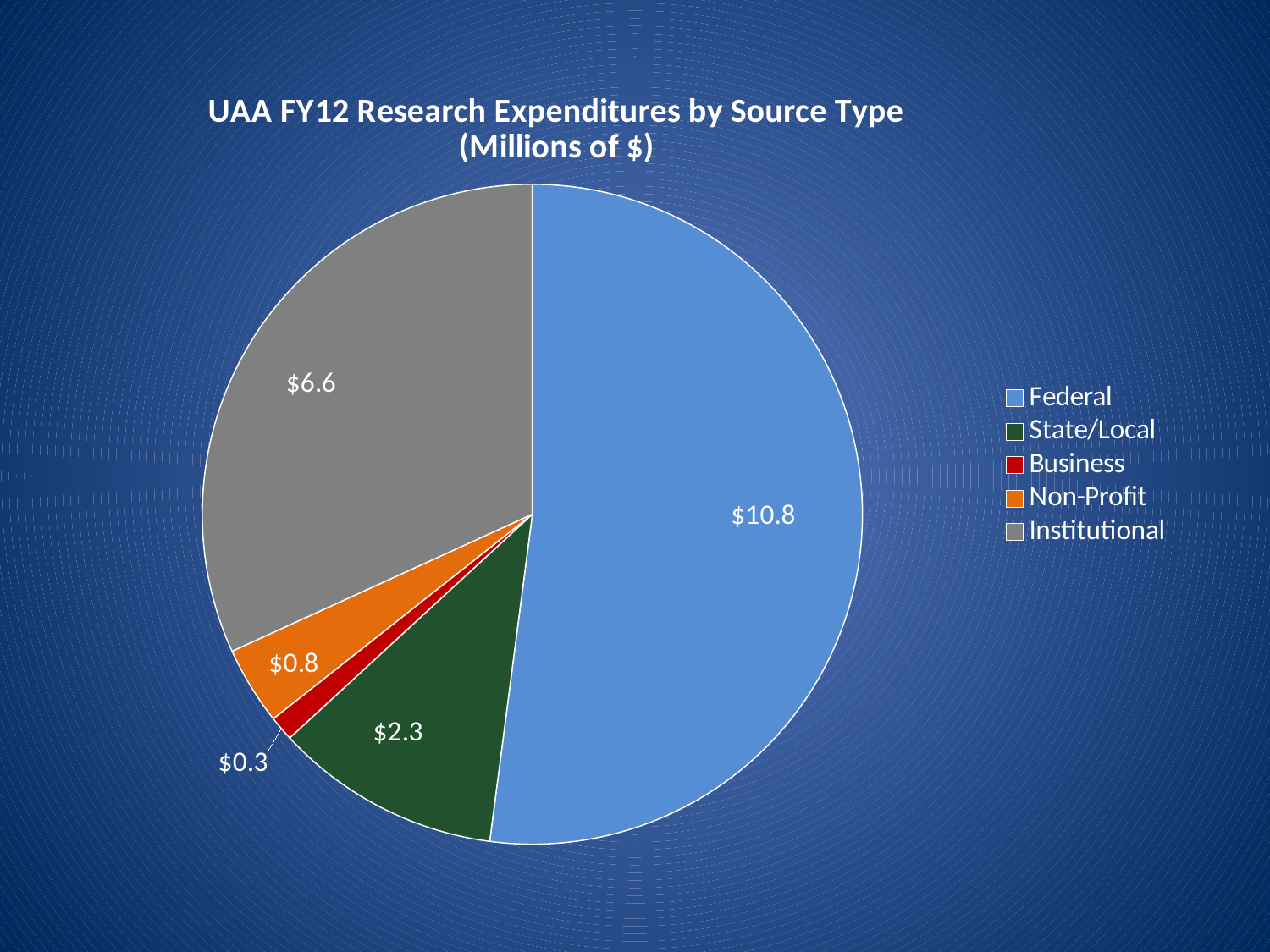
What is the total of all the slices? $20.8 What is the value for State/Local? $2.3 Which source type has the lowest expenditure? Business What kind of chart is shown on the slide? Pie chart What is the title of the chart? UAA FY12 Research Expenditures by Source Type (Millions of $) What is the difference between the Federal and Institutional values? $4.2 What is the value for Federal? $10.8 How many slices does the pie chart have? 5 Which is larger, State/Local or Non-Profit? State/Local Which source type has the highest expenditure? Federal What is the value for Business? $0.3 What is the value for Institutional? $6.6